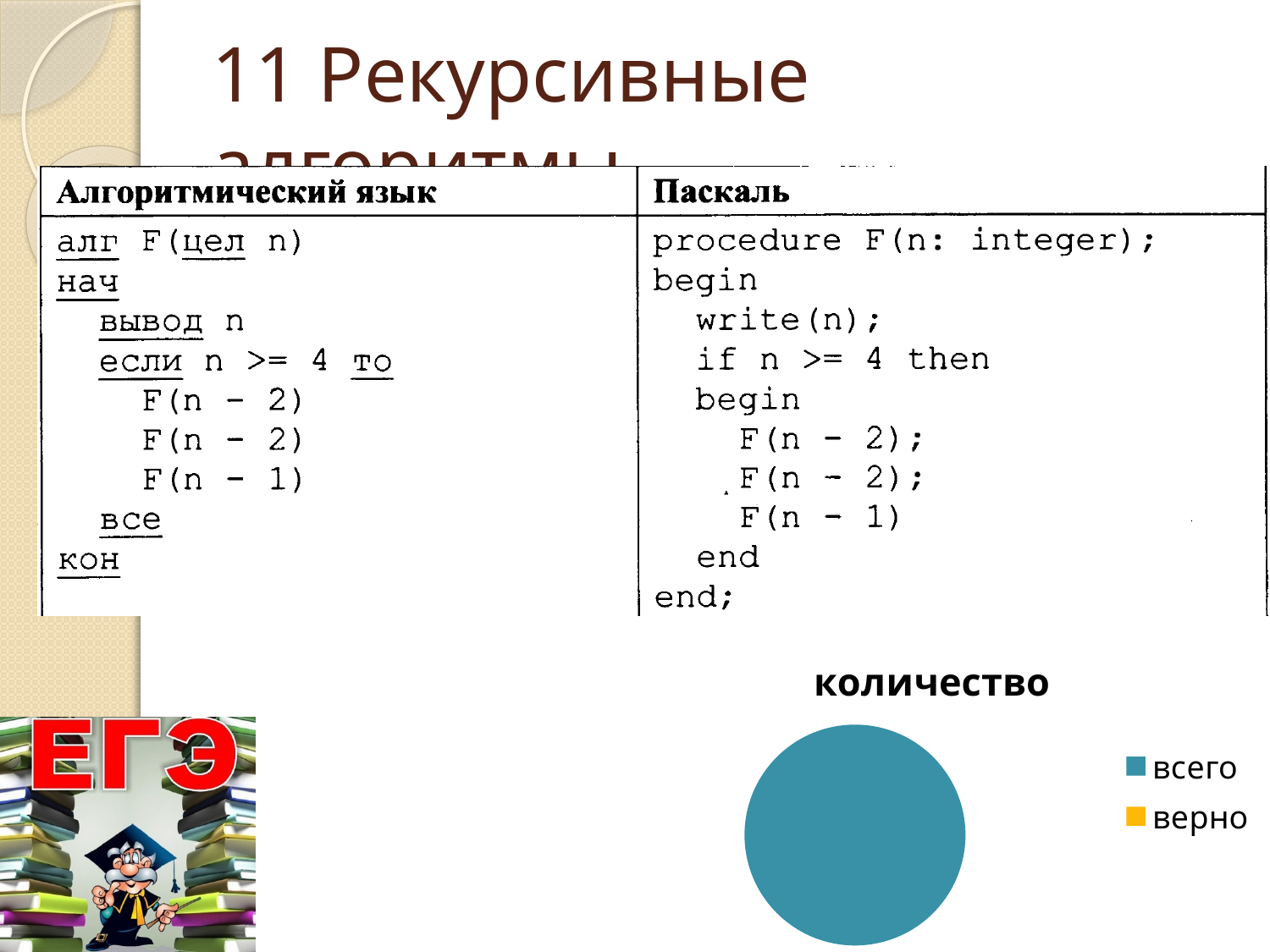
What colour represents всего in the pie chart? teal (blue-green) What is the title of the pie chart? количество Which category has the smallest share of the pie chart? верно How many entries does the legend of the pie chart list? 2 Which is larger in the pie chart, всего or верно? всего Which category takes up the largest share of the pie chart? всего What kind of chart is shown on the slide? pie chart